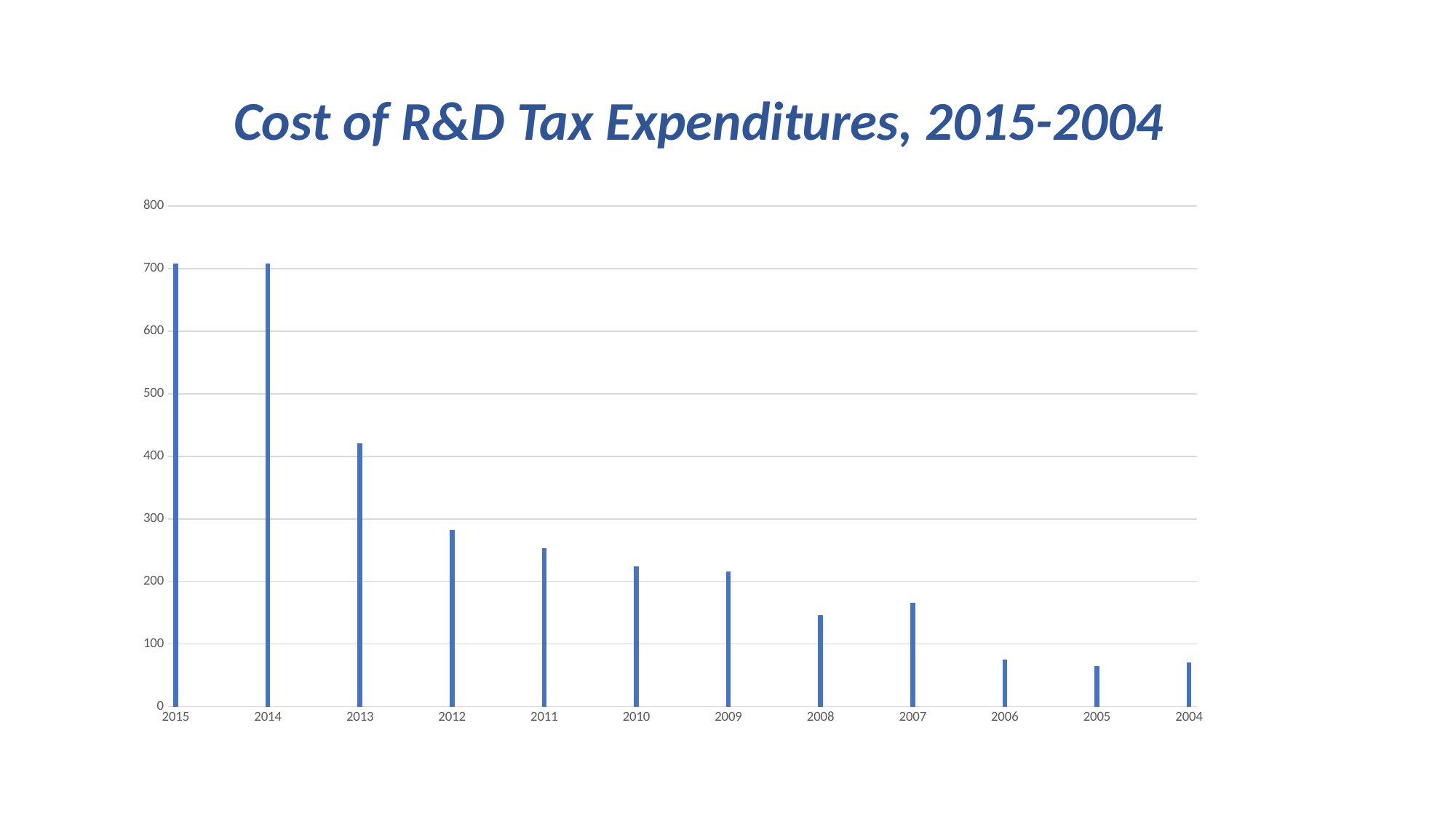
Is the value for 2006 greater or less than 100? less Do the values generally rise or fall moving from 2015 on the left to 2004 on the right? fall Is the value for 2012 greater or less than 300? less Is the value for 2008 greater or less than 200? less What kind of chart is shown on the slide? bar chart Which year has the larger value, 2013 or 2012? 2013 Which year has the larger value, 2011 or 2010? 2011 What is the title of the chart? Cost of R&D Tax Expenditures, 2015-2004 How many years are shown on the x axis of the chart? 12